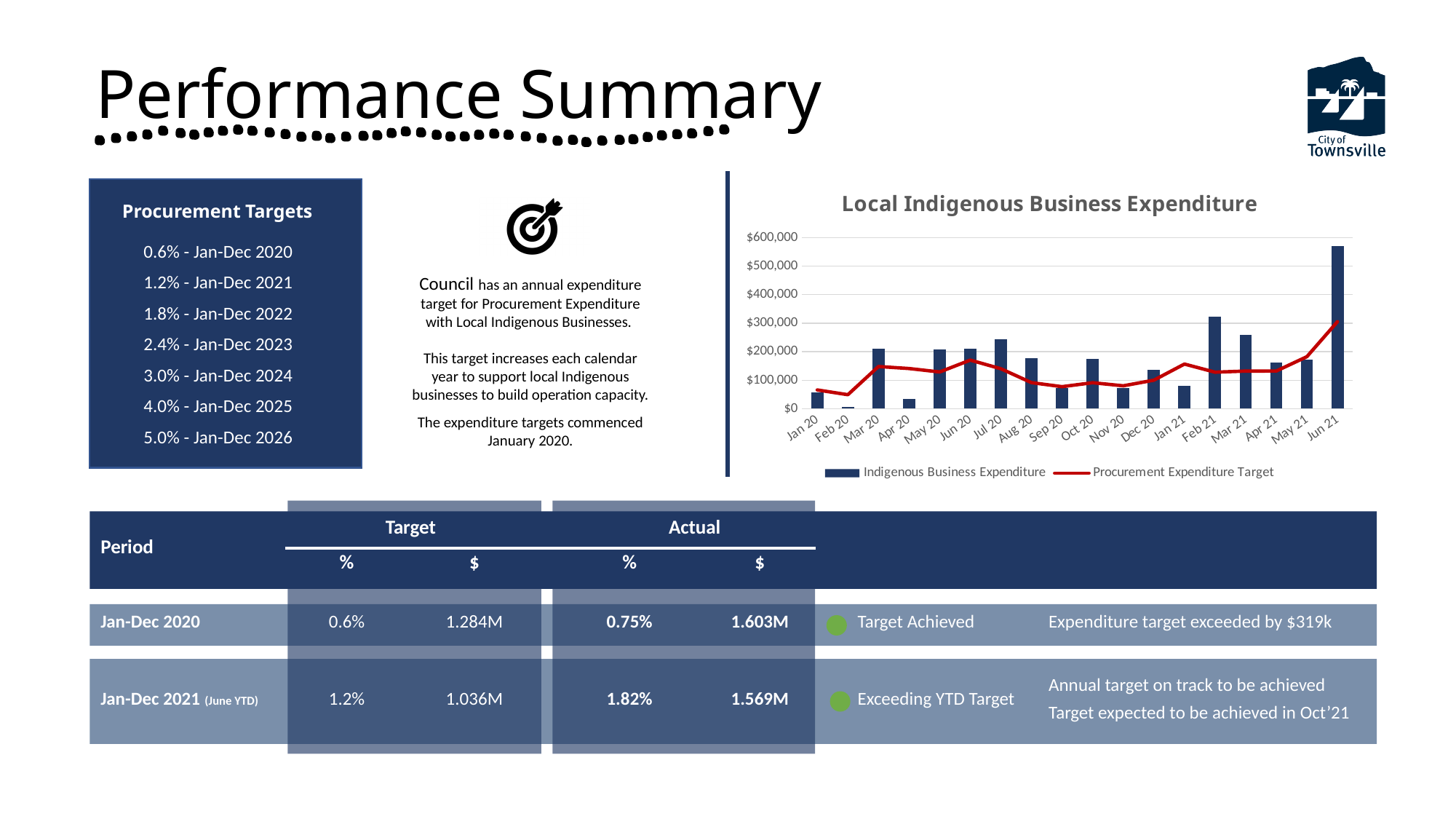
Is the Indigenous Business Expenditure for Feb 21 greater or less than $300,000? greater What is the title of the chart on the slide? Local Indigenous Business Expenditure Which month has the higher Indigenous Business Expenditure bar, Feb 21 or Mar 21? Feb 21 How many months are shown on the x axis of the Local Indigenous Business Expenditure chart? 18 Is the Indigenous Business Expenditure for Apr 20 greater or less than $100,000? less What colour is the Procurement Expenditure Target line in the chart? Red Is the Indigenous Business Expenditure for Jun 21 greater or less than $500,000? greater What kind of chart is the Local Indigenous Business Expenditure chart? Bar chart with a line overlay How many series does the legend of the Local Indigenous Business Expenditure chart list? 2 Which month has the highest Indigenous Business Expenditure bar? Jun 21 Which month has the lowest Indigenous Business Expenditure bar? Feb 20